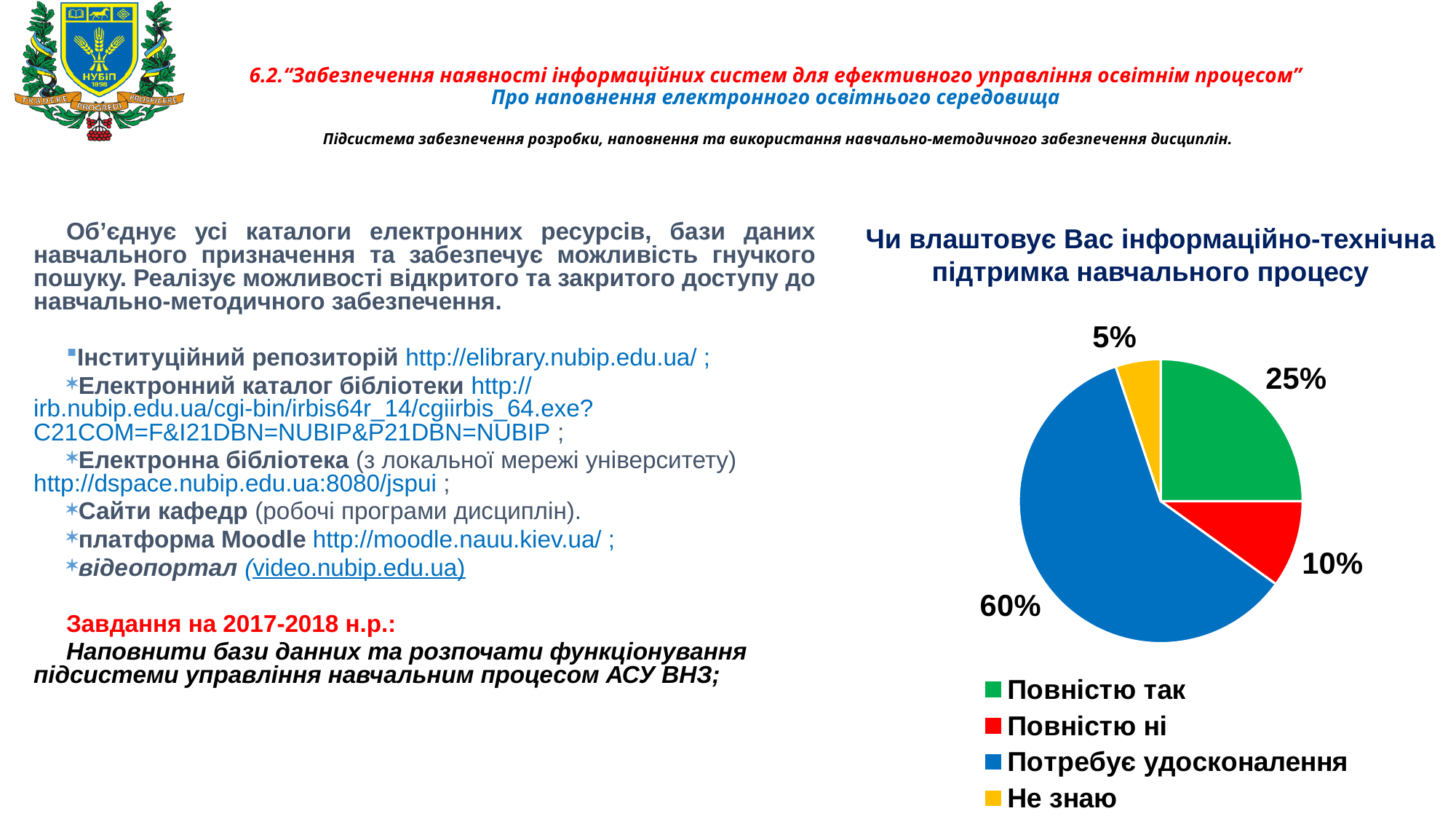
What share of the pie does "Потребує удосконалення" represent? 60% Which is larger: the share for "Повністю так" or the share for "Повністю ні"? Повністю так Which category has the largest slice of the pie? Потребує удосконалення What is the difference in percentage points between "Потребує удосконалення" and "Повністю так"? 35% What colour is the slice for "Потребує удосконалення"? Blue What type of chart is shown on the slide? Pie chart Which category has the smallest slice of the pie? Не знаю How many categories does the pie chart have? 4 What share of the pie does "Не знаю" represent? 5% What share of the pie does "Повністю ні" represent? 10% What is the title of the pie chart? Чи влаштовує Вас інформаційно-технічна підтримка навчального процесу